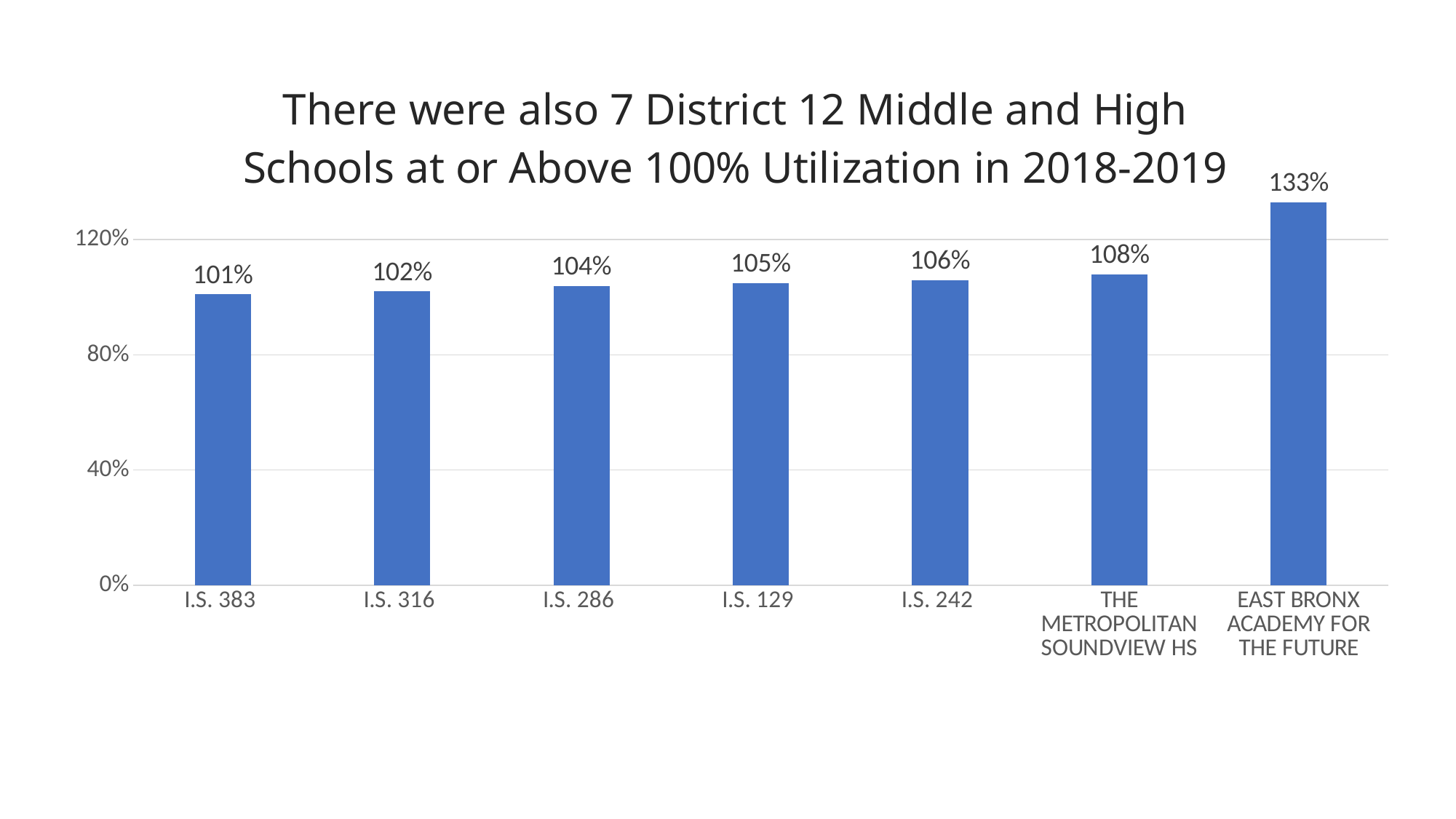
How many schools are shown in the chart? 7 Is the value for East Bronx Academy for the Future greater or less than 120%? greater What kind of chart is shown on the slide? Bar chart What is the difference between the utilization of The Metropolitan Soundview HS and I.S. 316? 6% What is the difference between the utilization of East Bronx Academy for the Future and I.S. 383? 32% Do the values rise or fall from left to right across the chart? Rise Which has a higher utilization, I.S. 242 or I.S. 286? I.S. 242 Which school has the highest utilization? East Bronx Academy for the Future What is the utilization value for I.S. 383? 101% What is the utilization value for The Metropolitan Soundview HS? 108% Which school has the lowest utilization? I.S. 383 What is the utilization value for I.S. 129? 105%